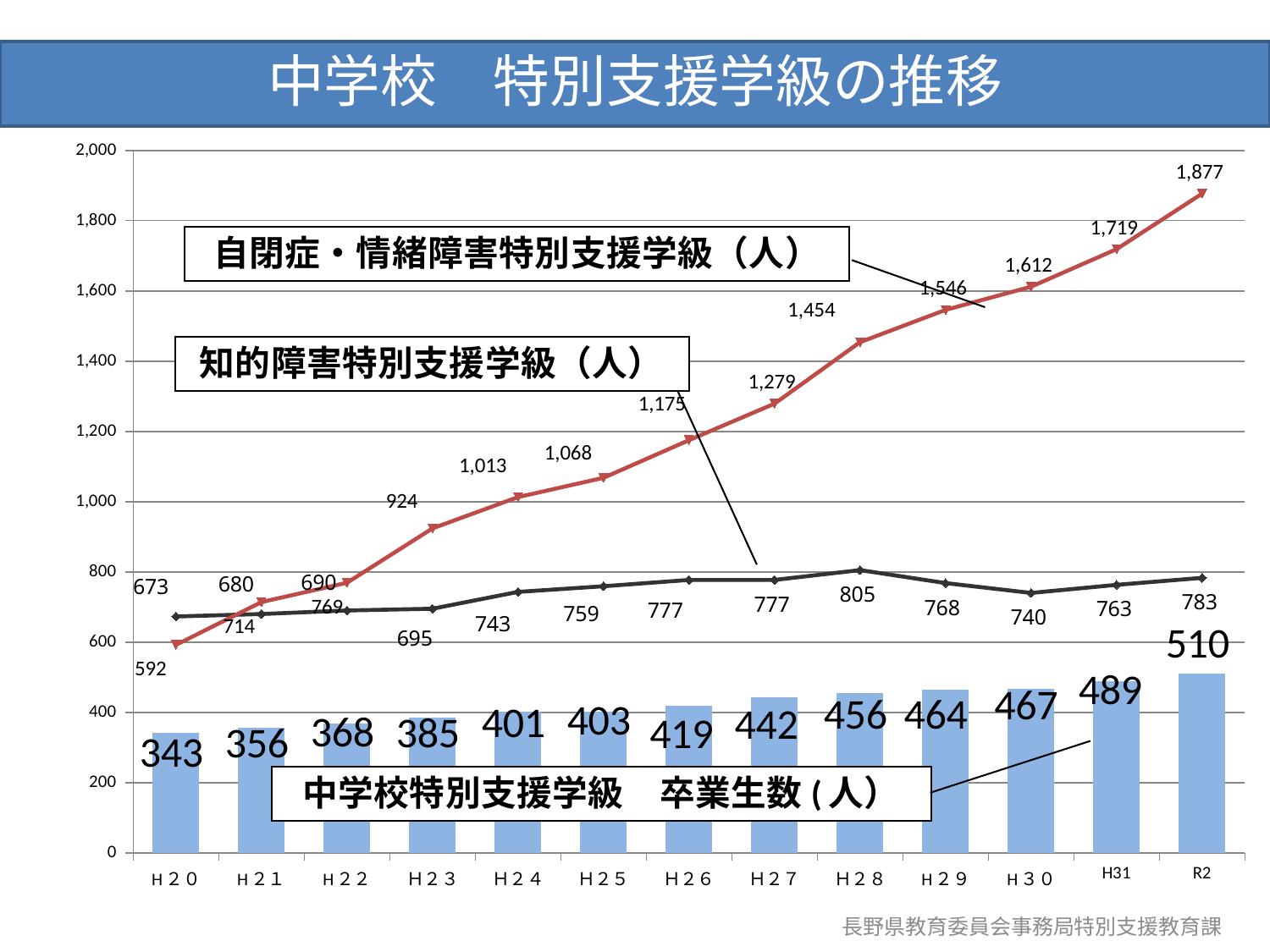
What is the difference between the 卒業生数 for R2 and for H31? 21 What is the title of the slide? 中学校 特別支援学級の推移 In which year is 自閉症・情緒障害特別支援学級（人） lowest? H20 What is the 中学校特別支援学級 卒業生数 for H20? 343 Does the 卒業生数 bar series rise or fall from H20 to R2? rise Which is larger in H20: 自閉症・情緒障害特別支援学級 or 知的障害特別支援学級? 知的障害特別支援学級 What colour is the line for 自閉症・情緒障害特別支援学級（人）? red What is the difference between the 自閉症・情緒障害特別支援学級 value for R2 and for H31? 158 In which year is 知的障害特別支援学級（人） highest? H28 What is the value of 知的障害特別支援学級（人） for H28? 805 What is the value of 自閉症・情緒障害特別支援学級（人） for R2? 1,877 How many years are shown on the x axis? 13